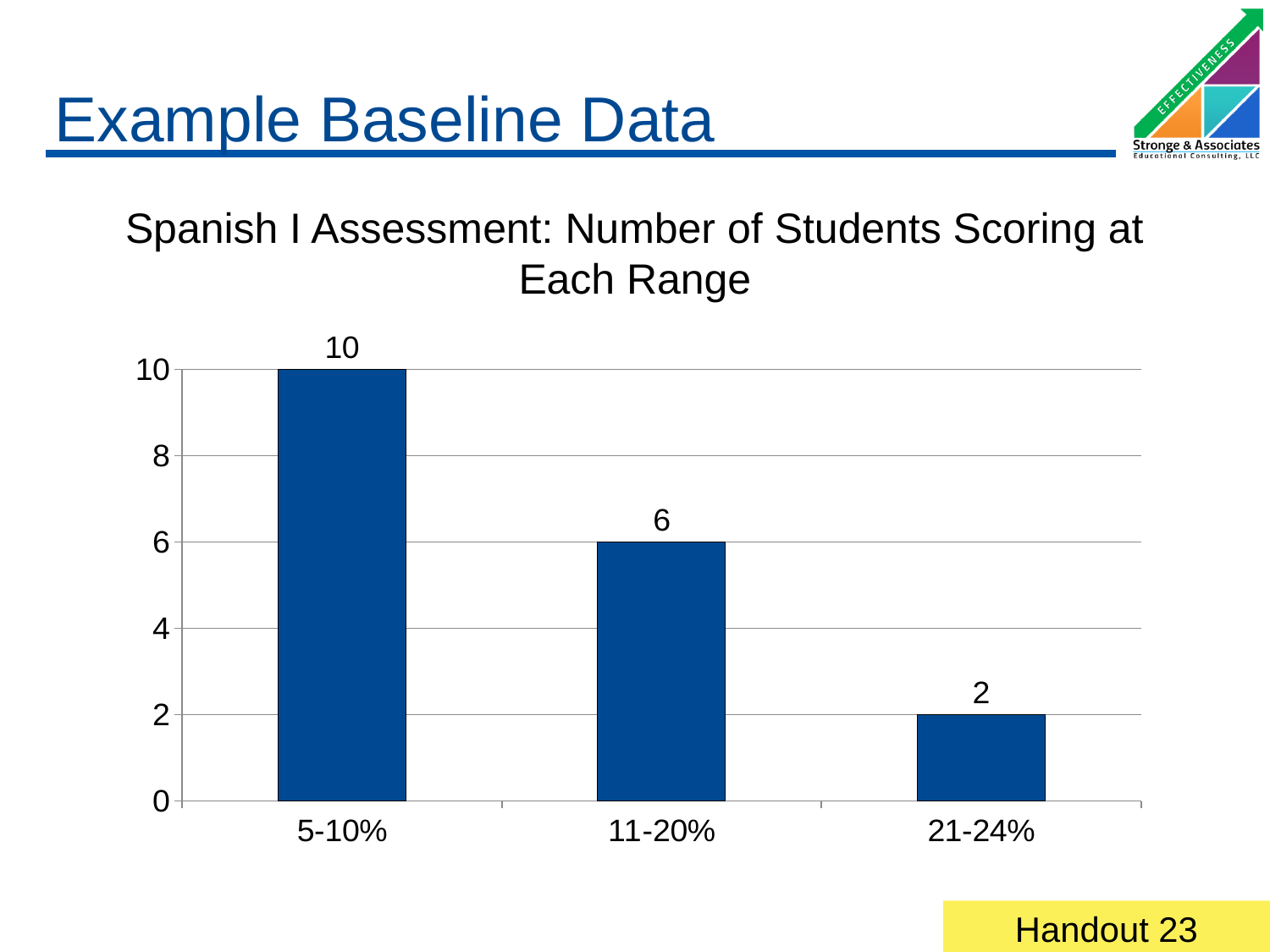
What is the title of the chart? Spanish I Assessment: Number of Students Scoring at Each Range How many score ranges are shown on the x axis? 3 What is the difference between the number of students in the 5-10% range and the 11-20% range? 4 How many students scored in the 5-10% range? 10 How many students scored in the 11-20% range? 6 How many students scored in the 21-24% range? 2 Which score range has the highest number of students? 5-10% Do the values rise or fall from left to right across the score ranges? Fall What is the difference between the number of students in the 11-20% range and the 21-24% range? 4 Which range has more students, 11-20% or 21-24%? 11-20% What kind of chart is shown on the slide? Bar chart Which score range has the lowest number of students? 21-24%